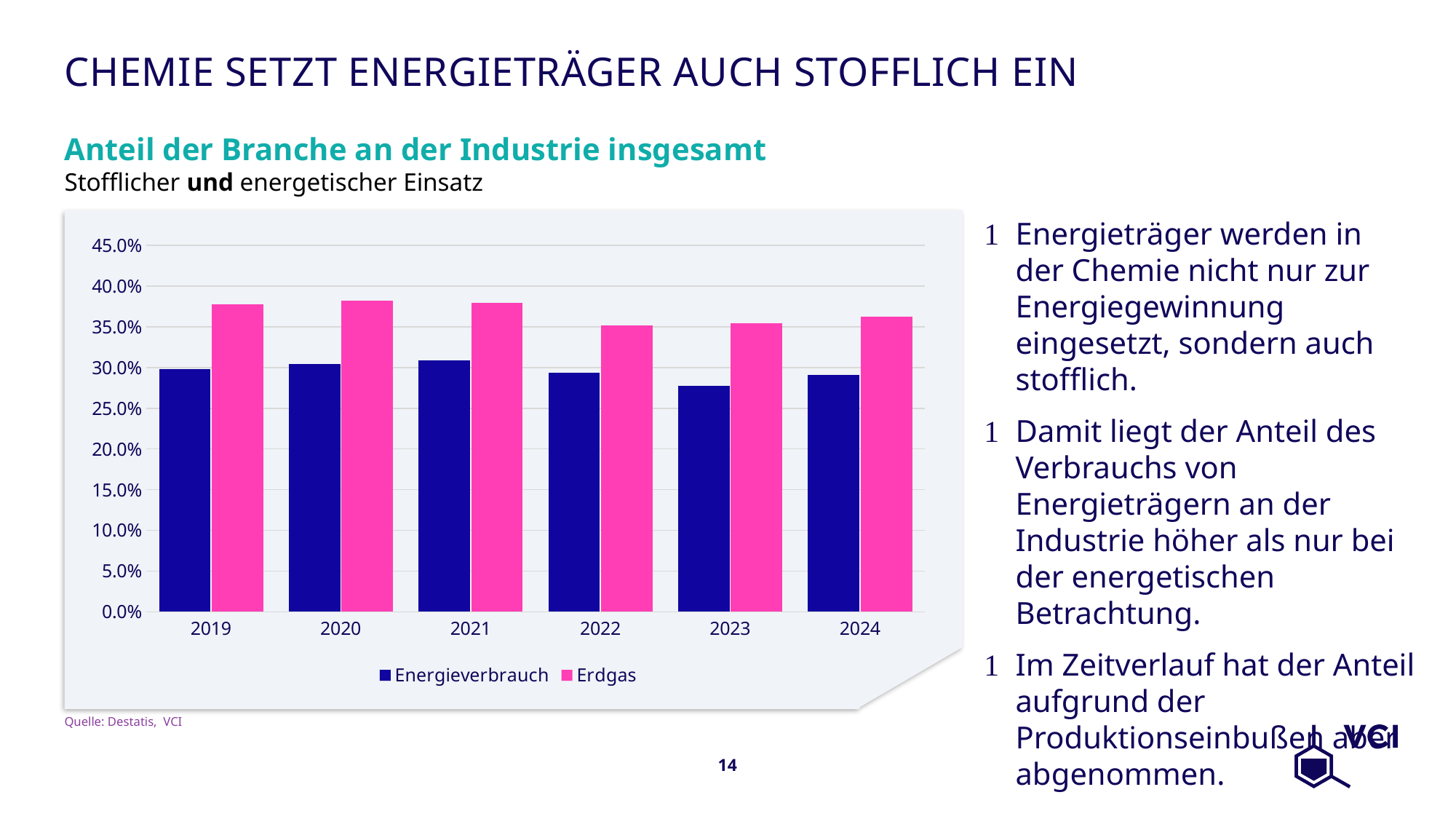
Which series is shown in pink? Erdgas What kind of chart is shown on the slide? bar chart Is the Erdgas value for 2019 greater or less than 35.0%? greater Does the Erdgas value rise or fall from 2021 to 2022? fall Is the Energieverbrauch value for 2023 greater or less than 30.0%? less Which is larger in 2022, Energieverbrauch or Erdgas? Erdgas How many years are shown on the x axis? 6 Is the Erdgas value for 2024 greater or less than 40.0%? less What is the title of the chart? Anteil der Branche an der Industrie insgesamt How many series does the legend list? 2 Which year has the larger Energieverbrauch value, 2021 or 2023? 2021 In which year is the Energieverbrauch value lowest? 2023